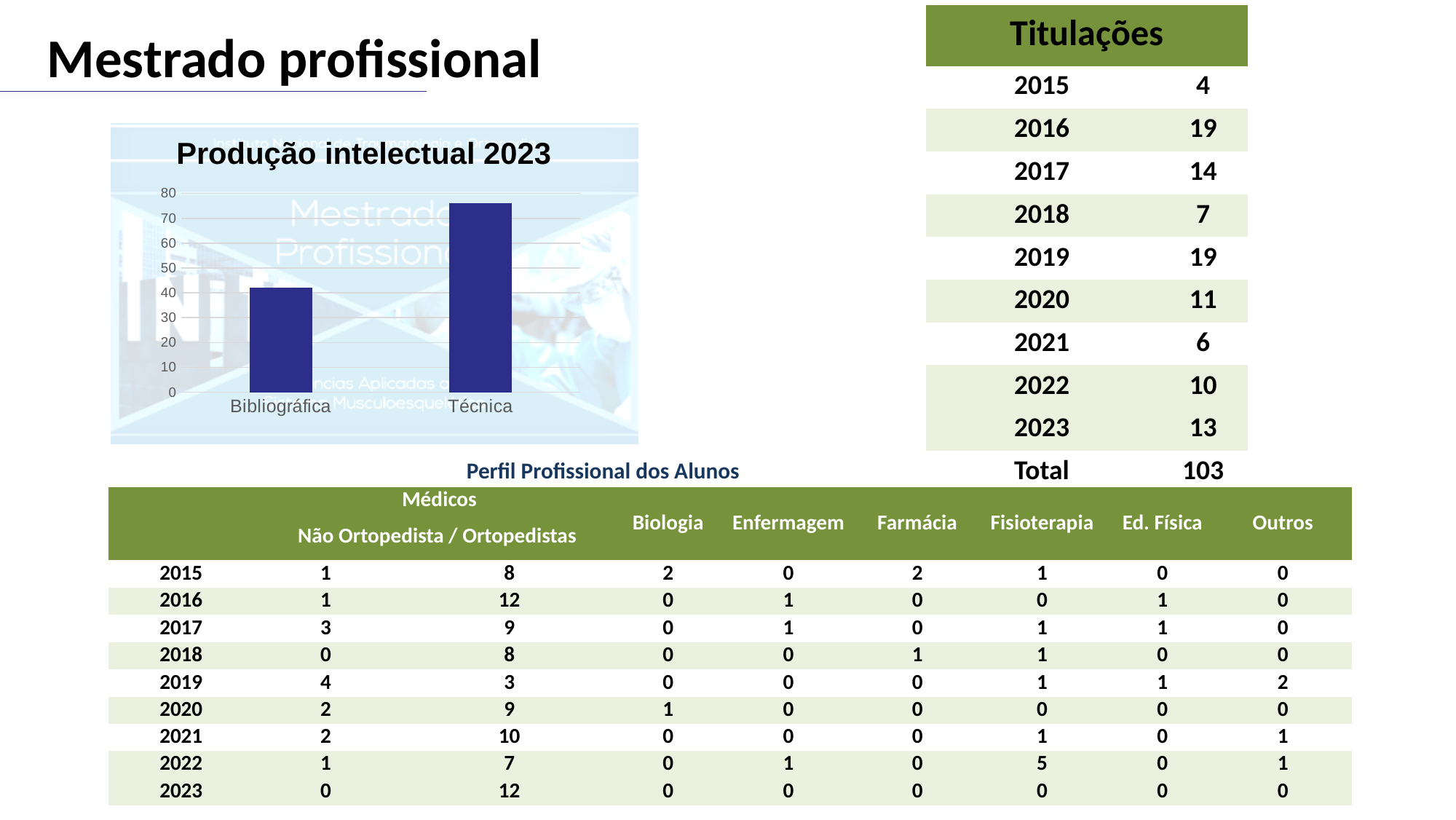
In the 'Produção intelectual 2023' chart, is the value for Técnica greater or less than 80? less What kind of chart is 'Produção intelectual 2023'? bar chart What is the highest value shown on the vertical axis of the 'Produção intelectual 2023' chart? 80 In the 'Produção intelectual 2023' chart, is the value for Bibliográfica greater or less than 30? greater In the 'Produção intelectual 2023' chart, is the value for Técnica greater or less than 70? greater What is the title of the bar chart on the slide? Produção intelectual 2023 Which category has the highest value in the 'Produção intelectual 2023' chart? Técnica How many categories are shown in the 'Produção intelectual 2023' chart? 2 Do the values in the 'Produção intelectual 2023' chart rise or fall from Bibliográfica to Técnica? rise Which category has the lowest value in the 'Produção intelectual 2023' chart? Bibliográfica In the 'Produção intelectual 2023' chart, which is larger, Bibliográfica or Técnica? Técnica